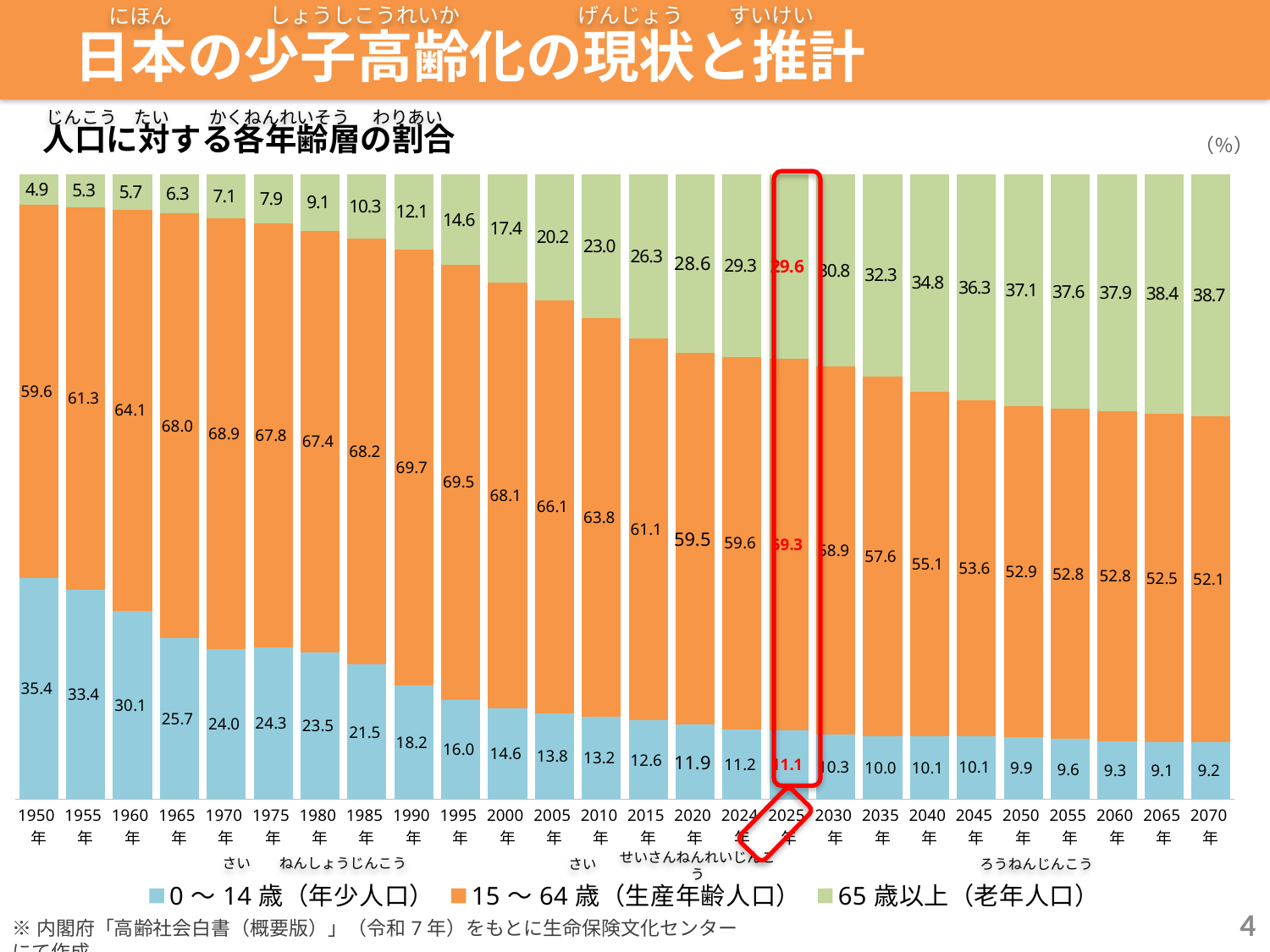
What is the value for 65歳以上（老年人口） in 1950年? 4.9 In which year is the 0～14歳（年少人口） share highest? 1950年 What is the value for 15～64歳（生産年齢人口） in 1990年? 69.7 What is the value for 0～14歳（年少人口） in 2070年? 9.2 Which is larger in 2025年: the 0～14歳（年少人口） share or the 65歳以上（老年人口） share? 65歳以上（老年人口） How many years (categories) are shown along the x axis? 26 What kind of chart is shown on the slide? stacked bar chart Which year's bar is highlighted with a red outline? 2025年 In which year is the 65歳以上（老年人口） share lowest? 1950年 Does the 65歳以上（老年人口） share rise or fall from 1950年 to 2070年? rise How many series does the legend list? 3 What is the difference between the 65歳以上（老年人口） values for 2070年 and 1950年? 33.8